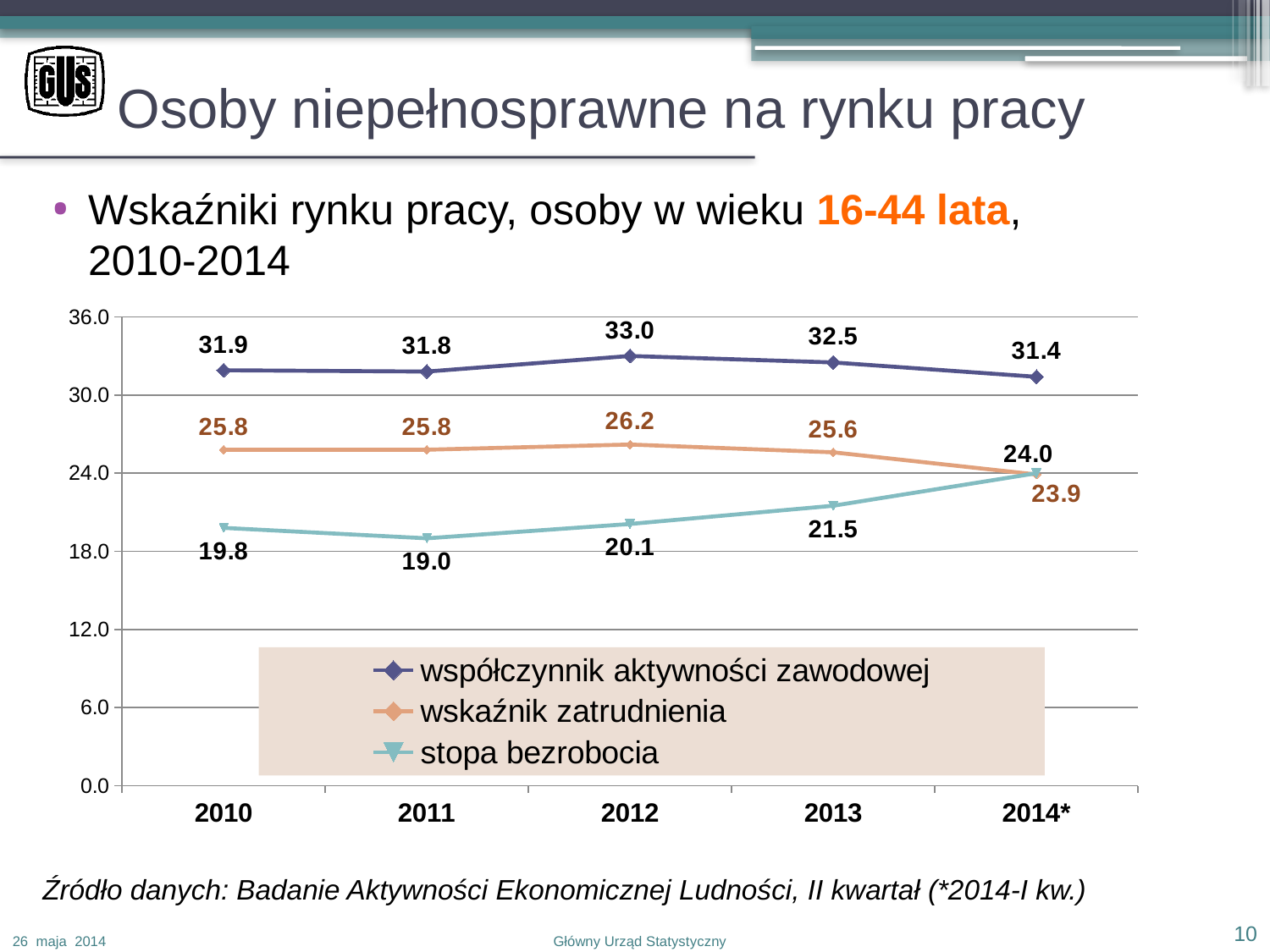
Which series is drawn with diamond markers? współczynnik aktywności zawodowej How many years are shown on the x axis? 5 Does stopa bezrobocia rise or fall from 2011 to 2014*? rise What is the value of wskaźnik zatrudnienia in 2014*? 23.9 What kind of chart is shown on the slide? line chart What is the value of współczynnik aktywności zawodowej in 2012? 33.0 What is the value of stopa bezrobocia in 2011? 19.0 In which year is współczynnik aktywności zawodowej highest? 2012 Which is larger in 2013: wskaźnik zatrudnienia or stopa bezrobocia? wskaźnik zatrudnienia What is the difference between stopa bezrobocia in 2014* and in 2010? 4.2 How many series does the legend list? 3 In which year is stopa bezrobocia lowest? 2011